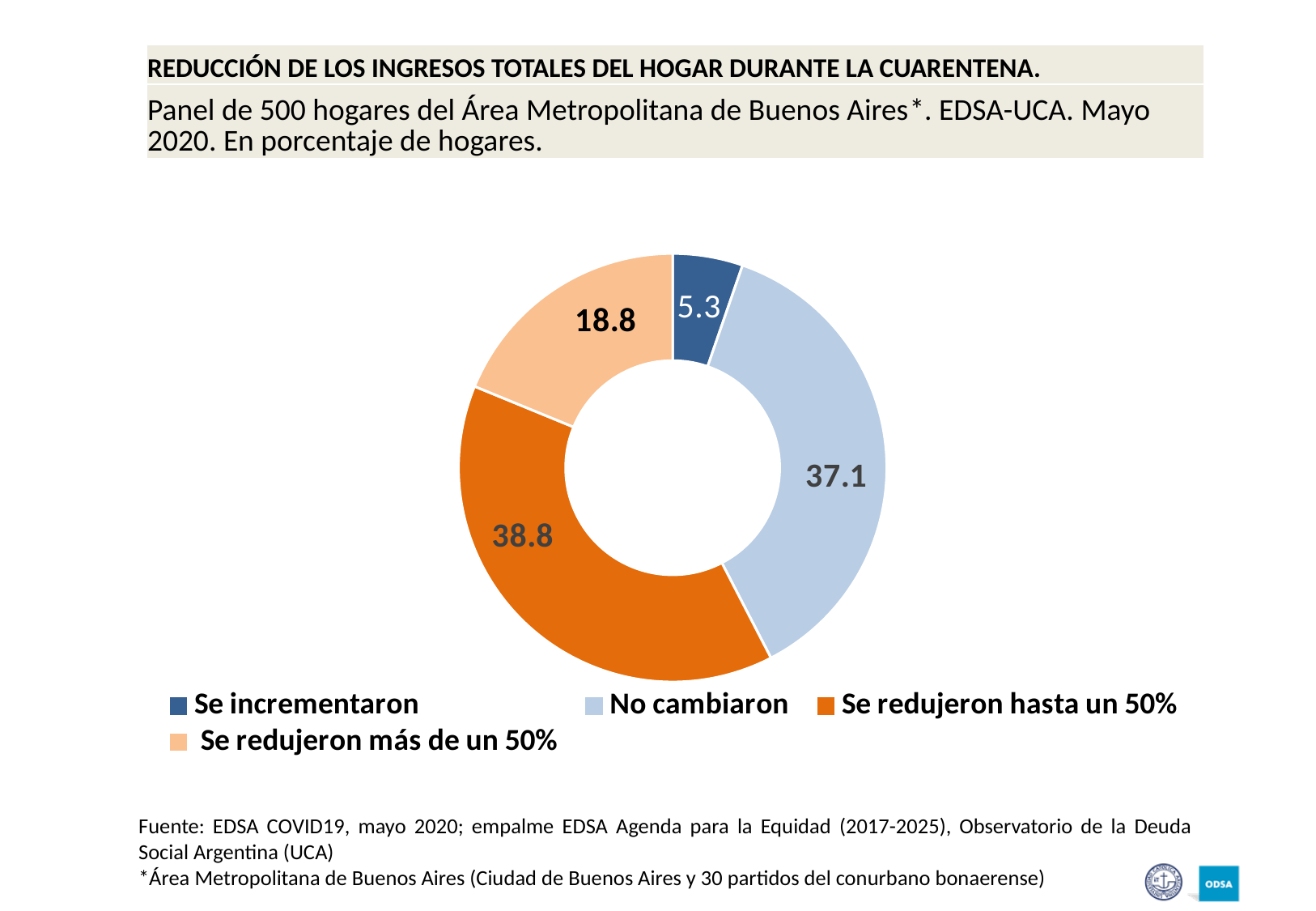
What is the combined value of the two 'Se redujeron' categories? 57.6 Which is larger: the value for 'No cambiaron' or the value for 'Se redujeron más de un 50%'? No cambiaron What kind of chart is shown on the slide? Pie chart (doughnut) How many categories does the chart show? 4 Which category has the smallest share of the chart? Se incrementaron What is the value for 'No cambiaron'? 37.1 What is the difference between the values for 'Se redujeron hasta un 50%' and 'No cambiaron'? 1.7 What is the value for 'Se redujeron más de un 50%'? 18.8 What percentage of households reported that their income 'Se incrementaron'? 5.3 What is the value for 'Se redujeron hasta un 50%'? 38.8 What colour is the slice for 'Se redujeron hasta un 50%'? Orange Which category has the largest share of the chart? Se redujeron hasta un 50%